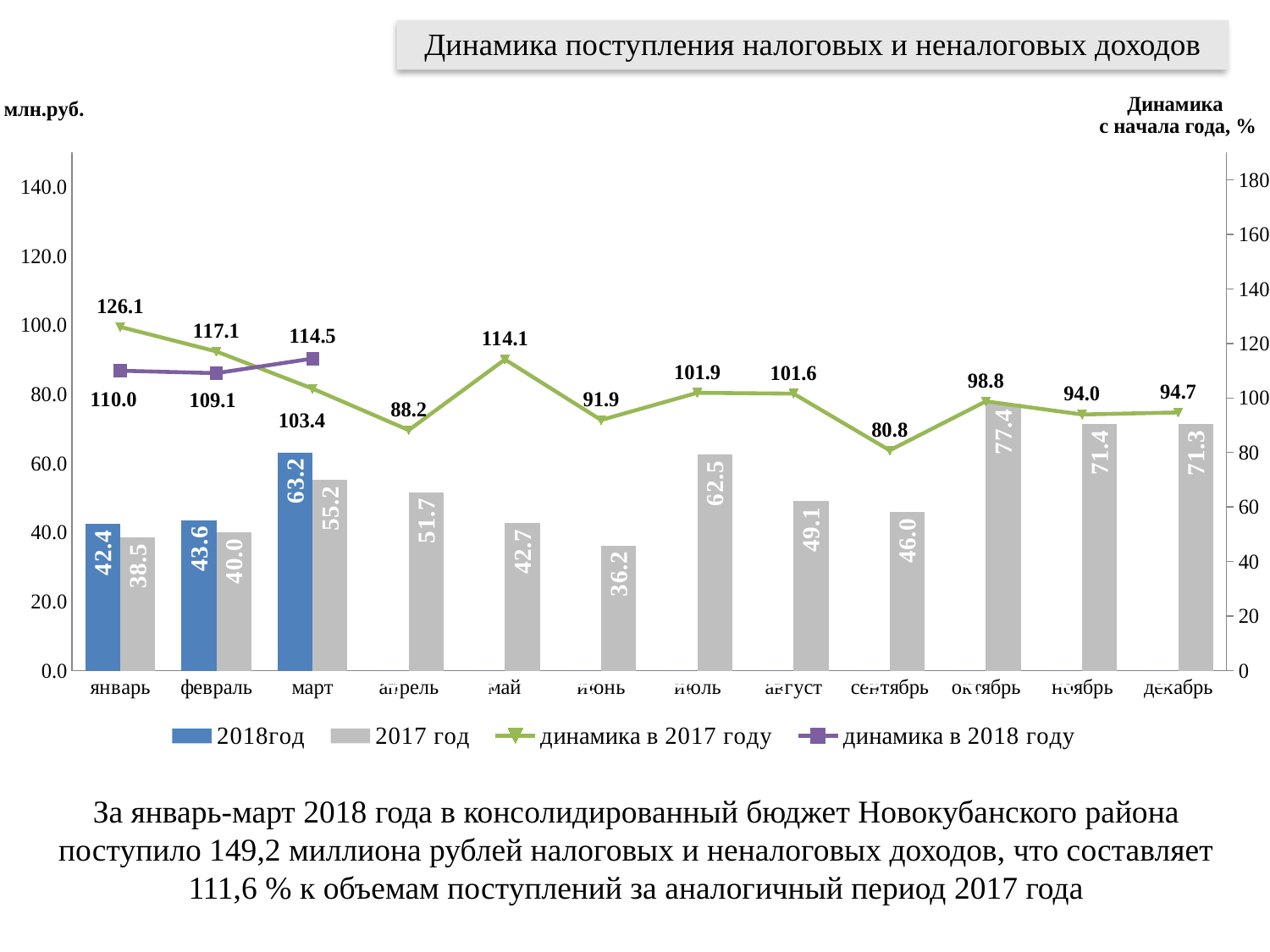
Does динамика в 2017 году rise or fall from январь to апрель? fall What is the value for октябрь in the 2017 год series? 77.4 How many series does the legend list? 4 Which month has the lowest value in the 2017 год series? июнь What is the value for март in the 2018год series? 63.2 What is the value of динамика в 2018 году for март? 114.5 What is the value of динамика в 2017 году for май? 114.1 Which month has the lowest value of динамика в 2017 году? сентябрь Which month has the highest value in the 2017 год series? октябрь For январь, which is larger: the 2018год value or the 2017 год value? 2018год What is the difference between the 2018год and 2017 год values for март? 8.0 How many months are shown on the x axis? 12